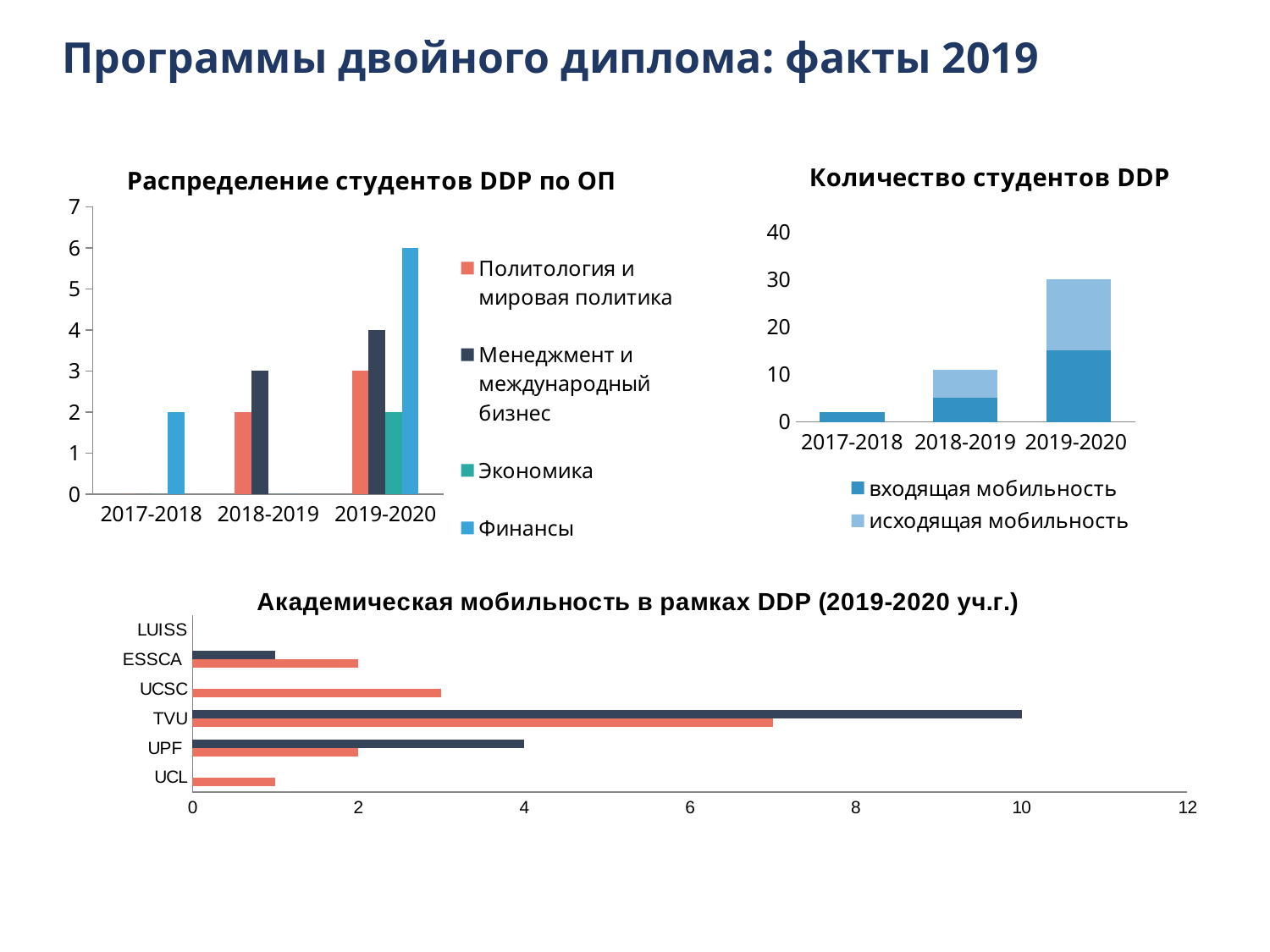
In the chart 'Распределение студентов DDP по ОП', which is larger in 2019-2020: Политология и мировая политика or Менеджмент и международный бизнес? Менеджмент и международный бизнес What kind of chart is 'Академическая мобильность в рамках DDP (2019-2020 уч.г.)'? bar chart In the chart 'Распределение студентов DDP по ОП', what is the value for Финансы in 2019-2020? 6 In the chart 'Академическая мобильность в рамках DDP (2019-2020 уч.г.)', how many universities are listed on the axis? 6 In the chart 'Количество студентов DDP', do the totals rise or fall from 2017-2018 to 2019-2020? rise In the chart 'Распределение студентов DDP по ОП', which programme has the highest value in 2019-2020? Финансы In the chart 'Количество студентов DDP', is the total for 2019-2020 greater or less than 20? greater In the chart 'Количество студентов DDP', which academic year has the highest total? 2019-2020 In the chart 'Распределение студентов DDP по ОП', what is the value for Менеджмент и международный бизнес in 2018-2019? 3 In the chart 'Распределение студентов DDP по ОП', what is the difference between Финансы and Экономика in 2019-2020? 4 In the chart 'Академическая мобильность в рамках DDP (2019-2020 уч.г.)', what is the value of the dark bar for TVU? 10 In the chart 'Распределение студентов DDP по ОП', how many series does the legend list? 4